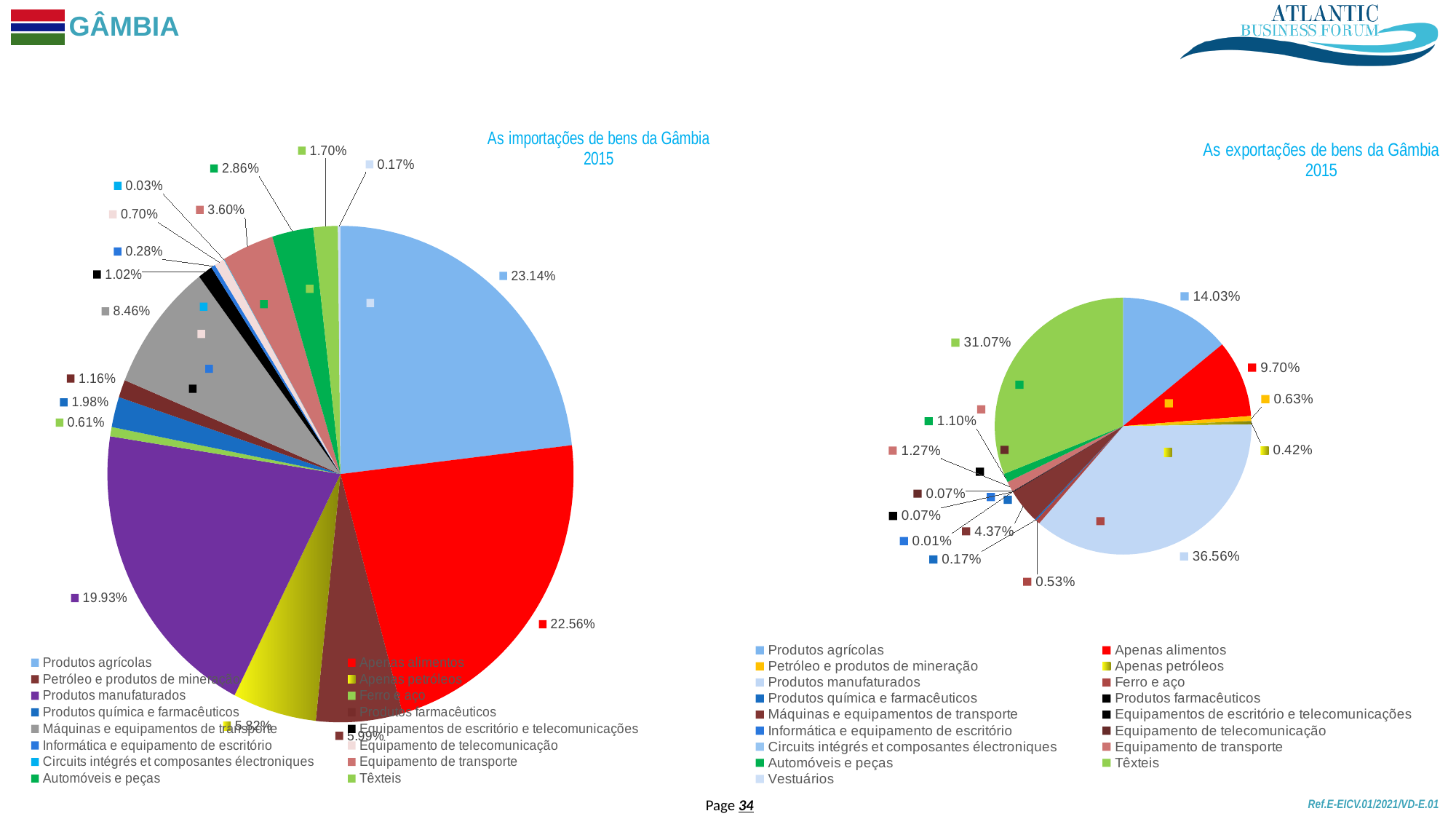
What kind of chart is used for 'As importações de bens da Gâmbia 2015'? Pie chart In the 'As exportações de bens da Gâmbia 2015' chart, what is the share of Produtos agrícolas? 14.03% In the 'As exportações de bens da Gâmbia 2015' chart, which is larger: Produtos manufaturados or Têxteis? Produtos manufaturados In the 'As importações de bens da Gâmbia 2015' chart, what is the difference in percentage points between Produtos agrícolas and Apenas alimentos? 0.58 In the 'As exportações de bens da Gâmbia 2015' chart, which category has the largest share? Produtos manufaturados In the 'As importações de bens da Gâmbia 2015' chart, what is the share of Apenas alimentos? 22.56% In the 'As importações de bens da Gâmbia 2015' chart, what is the share of Produtos manufaturados? 19.93% In the 'As exportações de bens da Gâmbia 2015' chart, what is the share of Apenas alimentos? 9.70% How many categories does the legend of the 'As exportações de bens da Gâmbia 2015' chart list? 17 In the 'As importações de bens da Gâmbia 2015' chart, what is the share of Máquinas e equipamentos de transporte? 8.46% In the 'As importações de bens da Gâmbia 2015' chart, which category has the largest share? Produtos agrícolas In the 'As exportações de bens da Gâmbia 2015' chart, what is the share of Têxteis? 31.07%